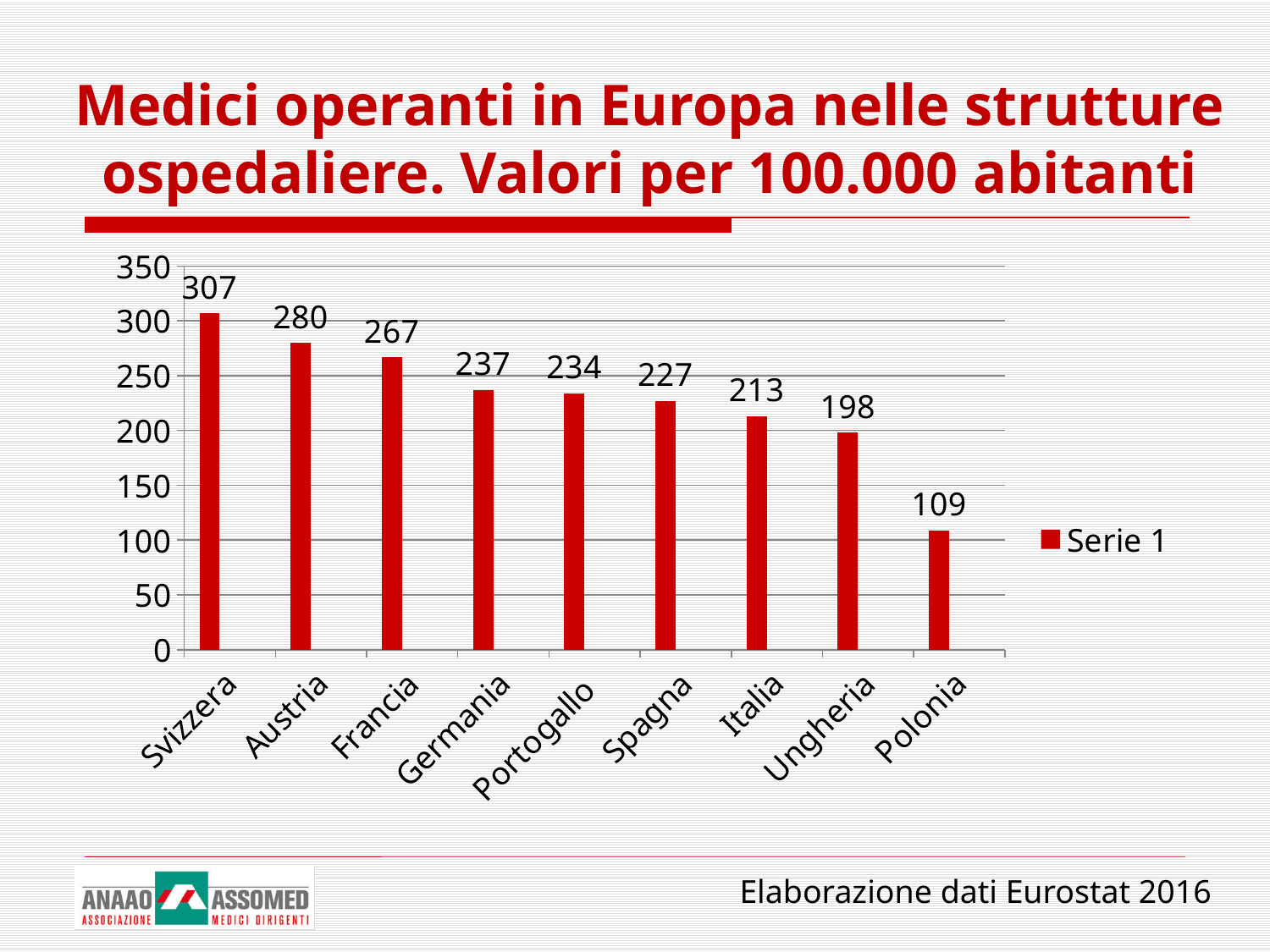
Which is larger, the value for Spagna or the value for Ungheria? Spagna What is the value for Germania? 237 How many series does the legend list? 1 What is the difference between the values for Svizzera and Polonia? 198 Do the values rise or fall from left to right along the x axis? fall Which country has the highest value? Svizzera Is the value for Ungheria greater or less than 200? less What kind of chart is shown on the slide? bar chart What is the value for Italia? 213 Which country has the lowest value? Polonia What is the difference between the values for Austria and Francia? 13 How many countries are shown on the chart? 9